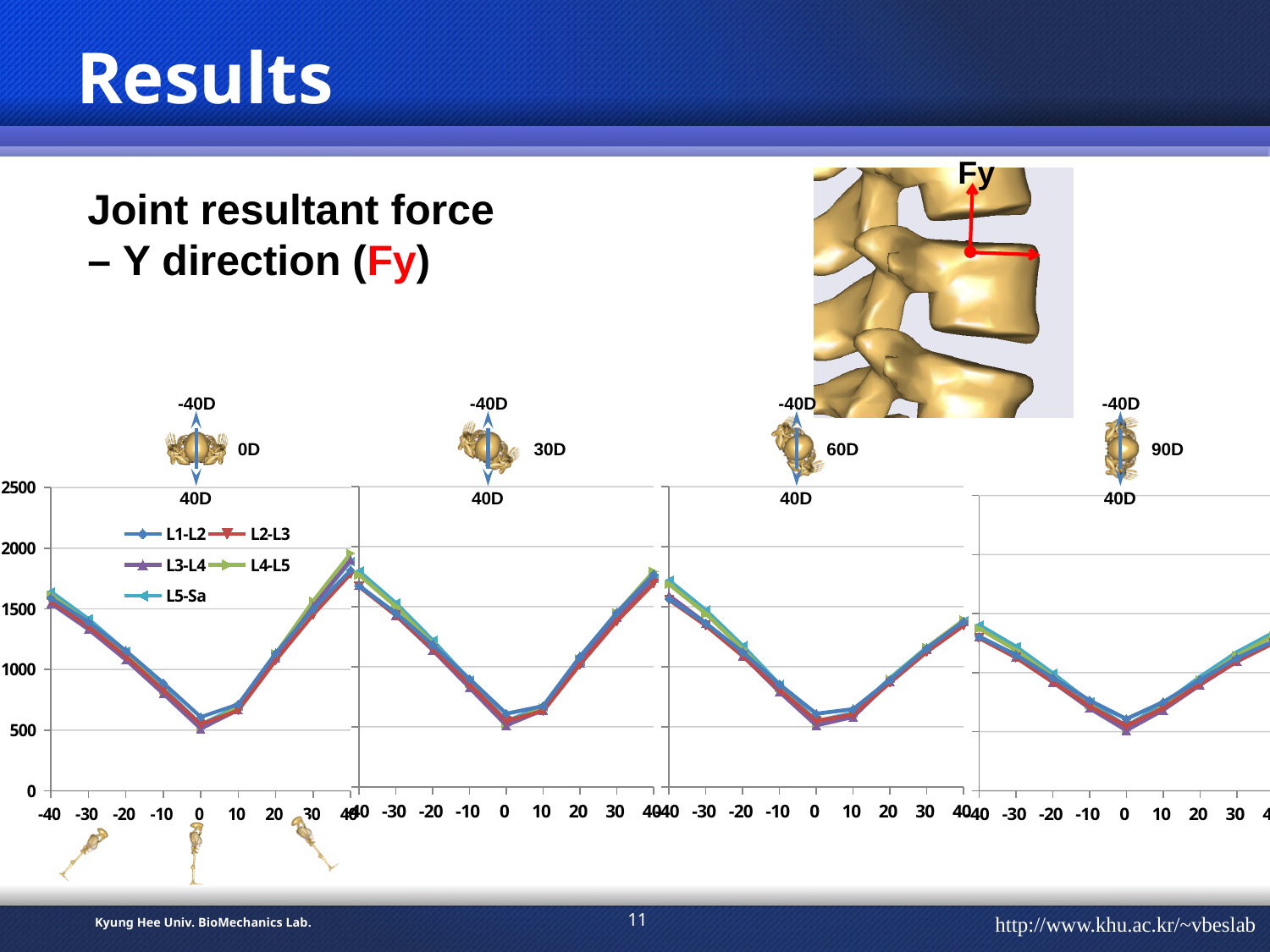
How many x-axis tick positions (data points per series) does the 0D chart have? 9 In the 60D chart, is the value for L1-L2 at x = 40 greater or less than 1000? greater In the 60D chart, which is larger for L1-L2: the value at x = -40 or the value at x = 40? x = -40 How many line charts are shown along the bottom of the slide? 4 In the 0D chart, is the value for L1-L2 at x = 0 greater or less than 1000? less How many series does the legend in the 0D chart list? 5 In the 30D chart, is the value for L2-L3 at x = 0 greater or less than 1000? less What kind of chart is used for the 0D panel on the slide? line chart In the 0D chart, do the values rise or fall as x goes from -40 to 0? fall In the 0D chart, at which x value do the series reach their lowest point? 0